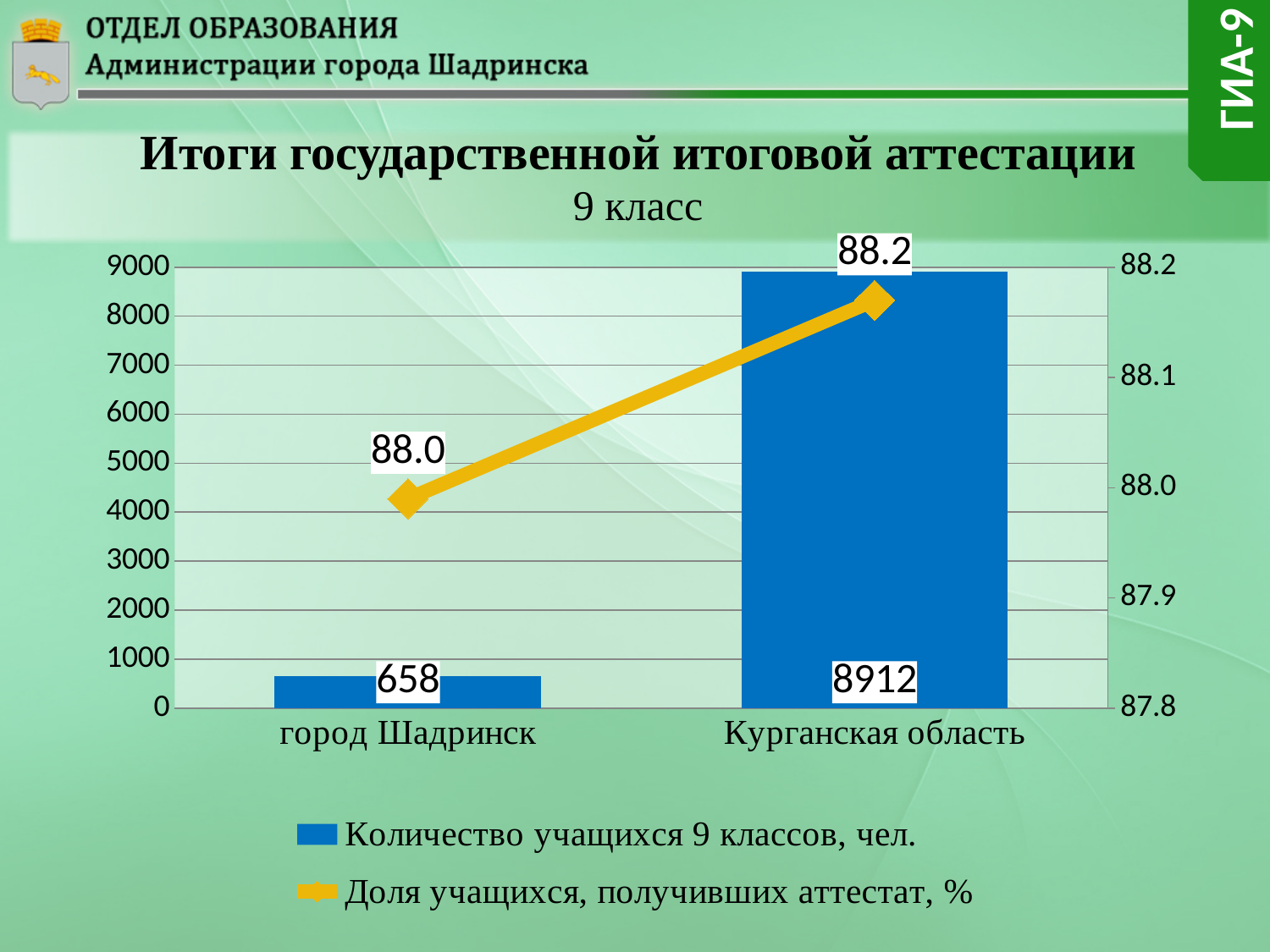
What is the share of students who received a certificate (Доля учащихся, получивших аттестат, %) for Курганская область? 88.2 What is the share of students who received a certificate (Доля учащихся, получивших аттестат, %) for город Шадринск? 88.0 What is the number of 9th-grade students (Количество учащихся 9 классов, чел.) for Курганская область? 8912 What is the difference in the number of 9th-grade students between Курганская область and город Шадринск? 8254 What is the difference in the share of students who received a certificate between Курганская область and город Шадринск? 0.2 Which category has the lower share of students who received a certificate? город Шадринск What is the number of 9th-grade students (Количество учащихся 9 классов, чел.) for город Шадринск? 658 How many series does the legend list? 2 Does the share of students who received a certificate rise or fall from город Шадринск to Курганская область? rise Which category has the higher number of 9th-grade students? Курганская область How many categories are shown on the x axis? 2 Is the number of 9th-grade students for город Шадринск greater or less than 1000? less